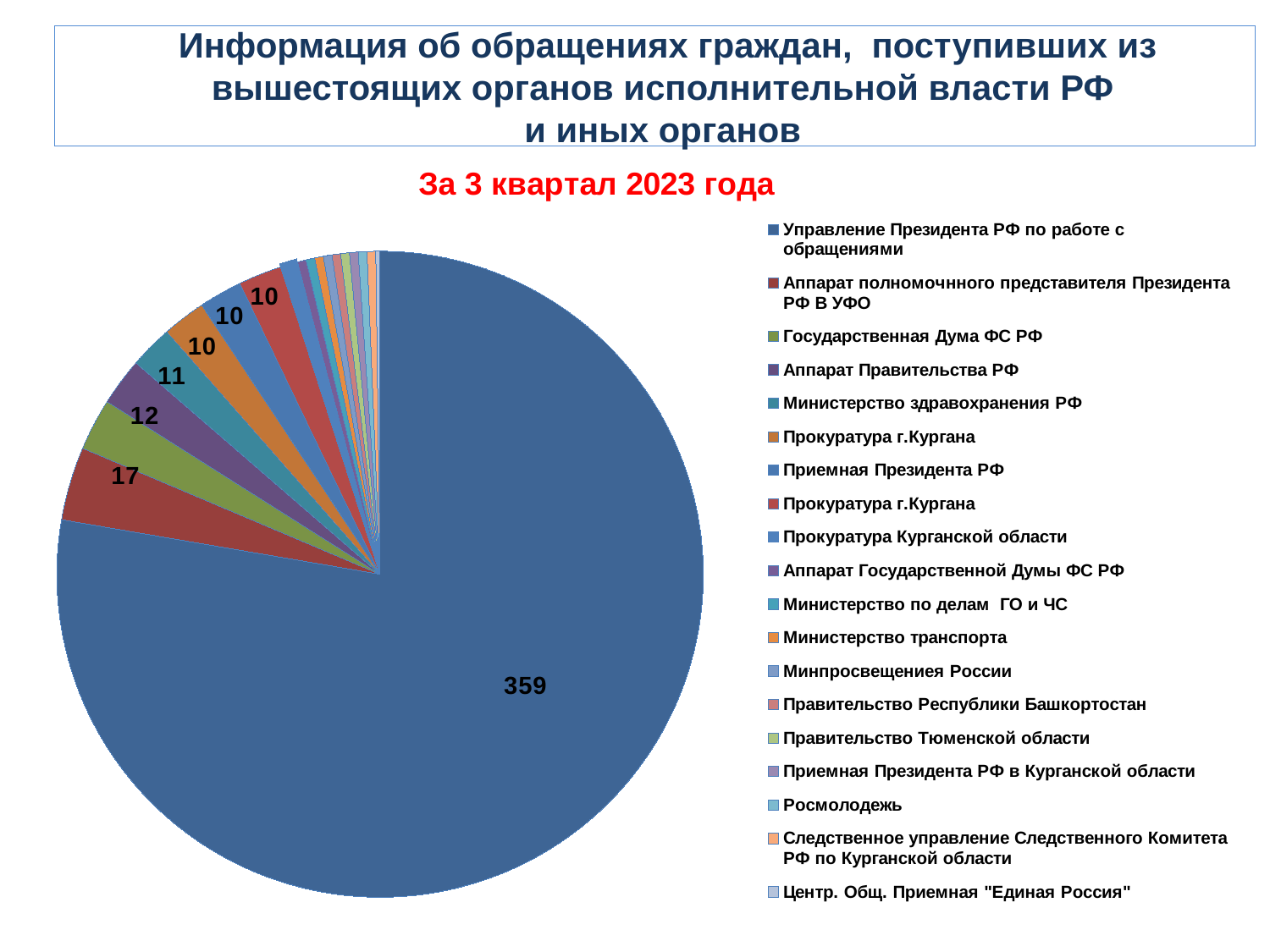
What is the difference between the values for Управление Президента РФ по работе с обращениями and Аппарат полномочного представителя Президента РФ в УФО? 342 What kind of chart is shown on the slide? pie chart What is the value for Аппарат Правительства РФ? 11 What period does the chart's subtitle say the data covers? За 3 квартал 2023 года What is the value for Управление Президента РФ по работе с обращениями? 359 How many categories does the legend list? 19 What is the value for Министерство здравоохранения РФ? 10 Which is larger, the value for Государственная Дума ФС РФ or the value for Аппарат Правительства РФ? Государственная Дума ФС РФ What is the difference between the values for Аппарат полномочного представителя Президента РФ в УФО and Государственная Дума ФС РФ? 5 Which category has the largest slice of the pie? Управление Президента РФ по работе с обращениями What is the value for Аппарат полномочного представителя Президента РФ в УФО? 17 What is the value for Государственная Дума ФС РФ? 12